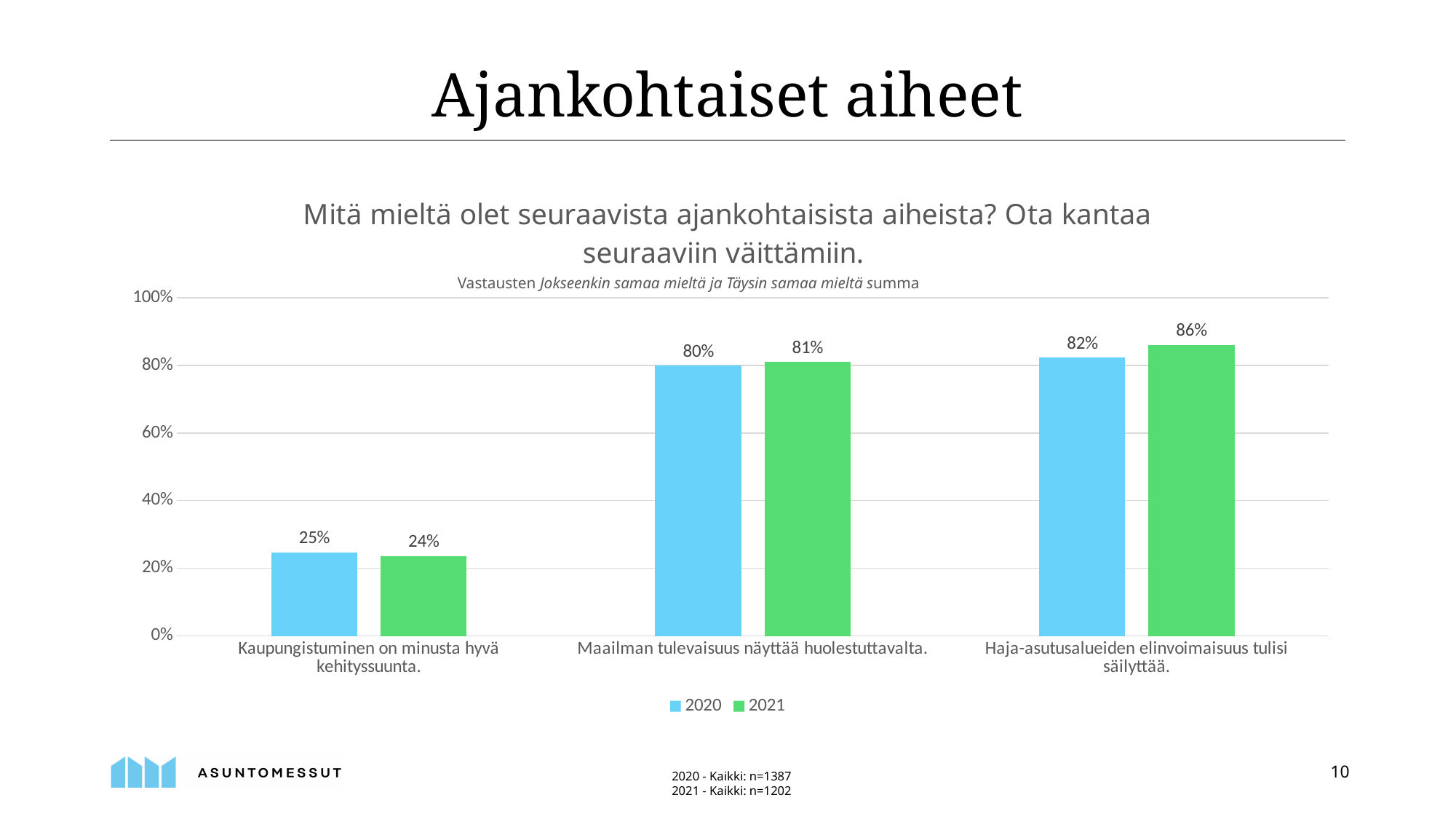
Which category has the lowest 2020 value? Kaupungistuminen on minusta hyvä kehityssuunta. How many series does the legend list? 2 Which is larger for "Kaupungistuminen on minusta hyvä kehityssuunta.": the 2020 value or the 2021 value? 2020 Is the 2020 value for "Maailman tulevaisuus näyttää huolestuttavalta." greater or less than 60%? greater What is the 2021 value for "Maailman tulevaisuus näyttää huolestuttavalta."? 81% Which colour represents the 2021 series? Green What is the 2021 value for "Haja-asutusalueiden elinvoimaisuus tulisi säilyttää."? 86% What is the 2020 value for "Kaupungistuminen on minusta hyvä kehityssuunta."? 25% Which category has the highest 2021 value? Haja-asutusalueiden elinvoimaisuus tulisi säilyttää. What kind of chart is shown on the slide? Bar chart What is the difference between the 2021 and 2020 values for "Haja-asutusalueiden elinvoimaisuus tulisi säilyttää."? 4% How many categories are shown on the x axis? 3